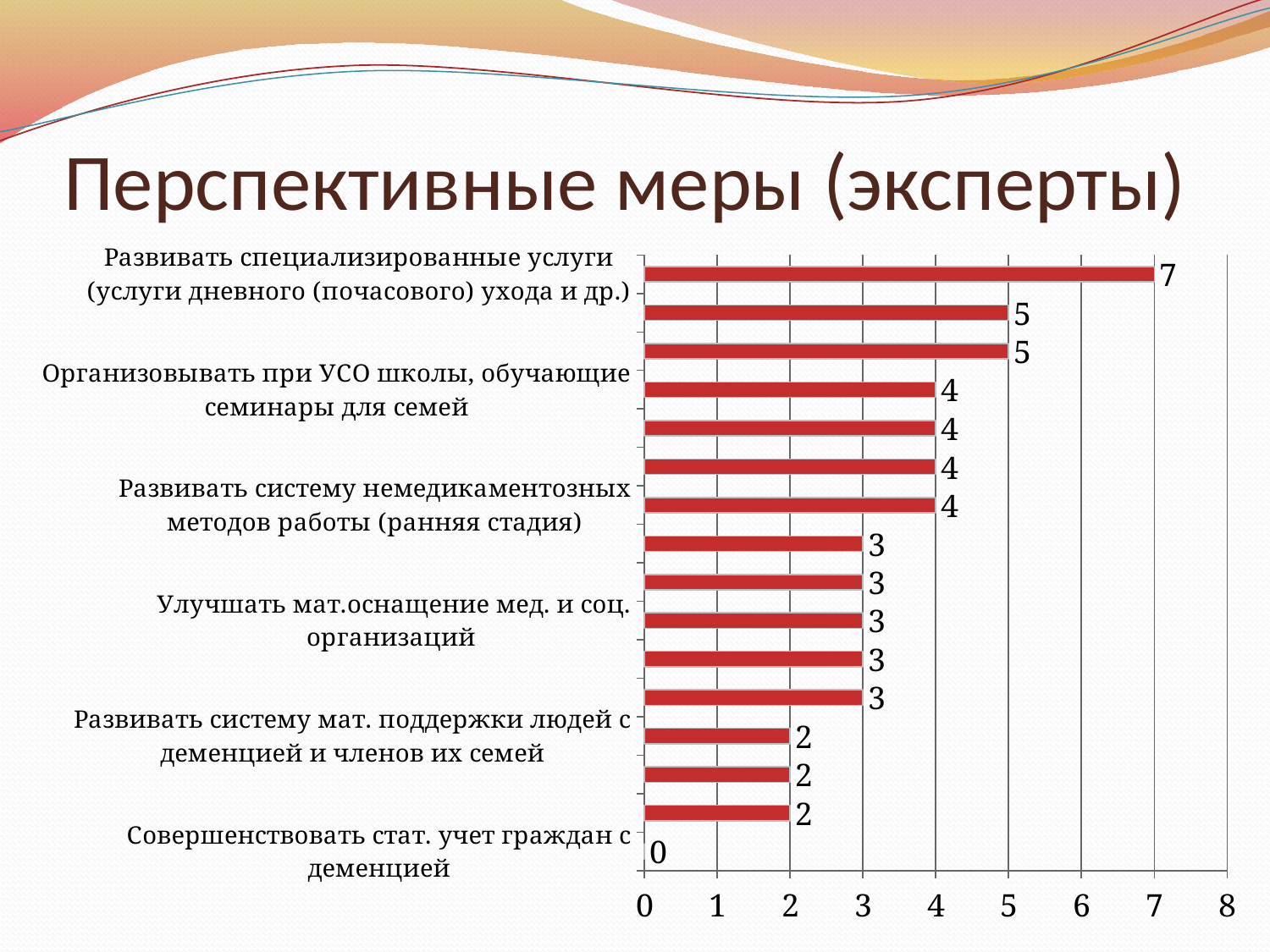
Which category has the lowest value? Совершенствовать стат. учет граждан с деменцией What is the title of the chart on the slide? Перспективные меры (эксперты) What is the value for "Развивать систему мат. поддержки людей с деменцией и членов их семей"? 2 What type of chart is shown on the slide? bar chart How many bars are plotted in the chart? 16 What is the value for "Развивать специализированные услуги (услуги дневного (почасового) ухода и др.)"? 7 What is the value for "Организовывать при УСО школы, обучающие семинары для семей"? 4 What is the value for "Улучшать мат.оснащение мед. и соц. организаций"? 3 Which category has the highest value? Развивать специализированные услуги (услуги дневного (почасового) ухода и др.) What is the difference between the value for "Развивать специализированные услуги (услуги дневного (почасового) ухода и др.)" and the value for "Улучшать мат.оснащение мед. и соц. организаций"? 4 What is the value for "Развивать систему немедикаментозных методов работы (ранняя стадия)"? 4 What is the value for "Совершенствовать стат. учет граждан с деменцией"? 0